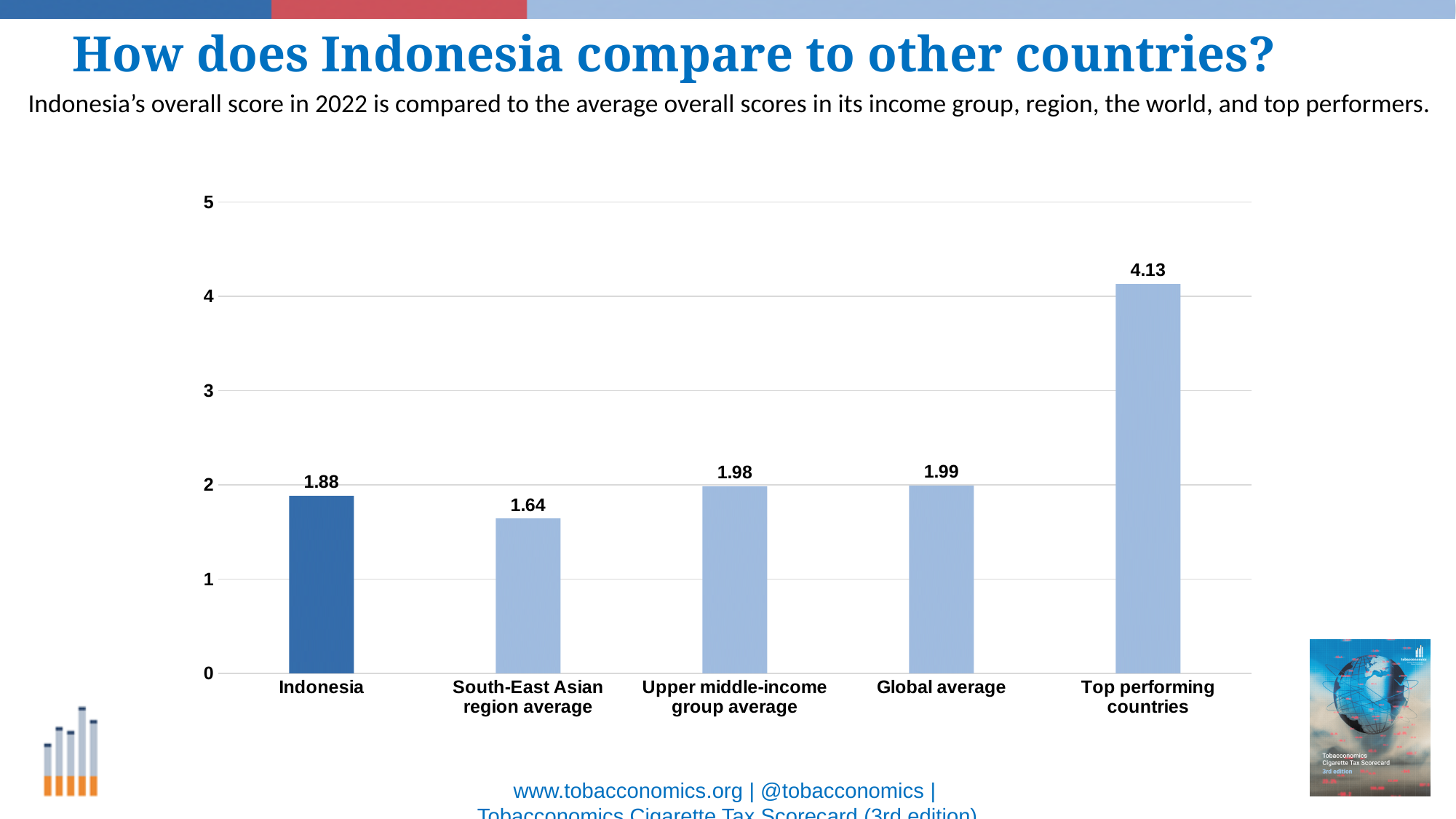
What kind of chart is shown on the slide? Bar chart What is the value for the South-East Asian region average? 1.64 Is the value for Top performing countries greater or less than 4? greater What is the value for the Global average? 1.99 What is the value for Top performing countries? 4.13 How many categories are shown on the x axis? 5 Which category has the highest value? Top performing countries What is the value for Indonesia? 1.88 What is the difference between the value for Top performing countries and the value for Indonesia? 2.25 Which category has the lowest value? South-East Asian region average What is the difference between the value for Indonesia and the South-East Asian region average? 0.24 Which is larger, the value for Indonesia or the value for the Upper middle-income group average? Upper middle-income group average